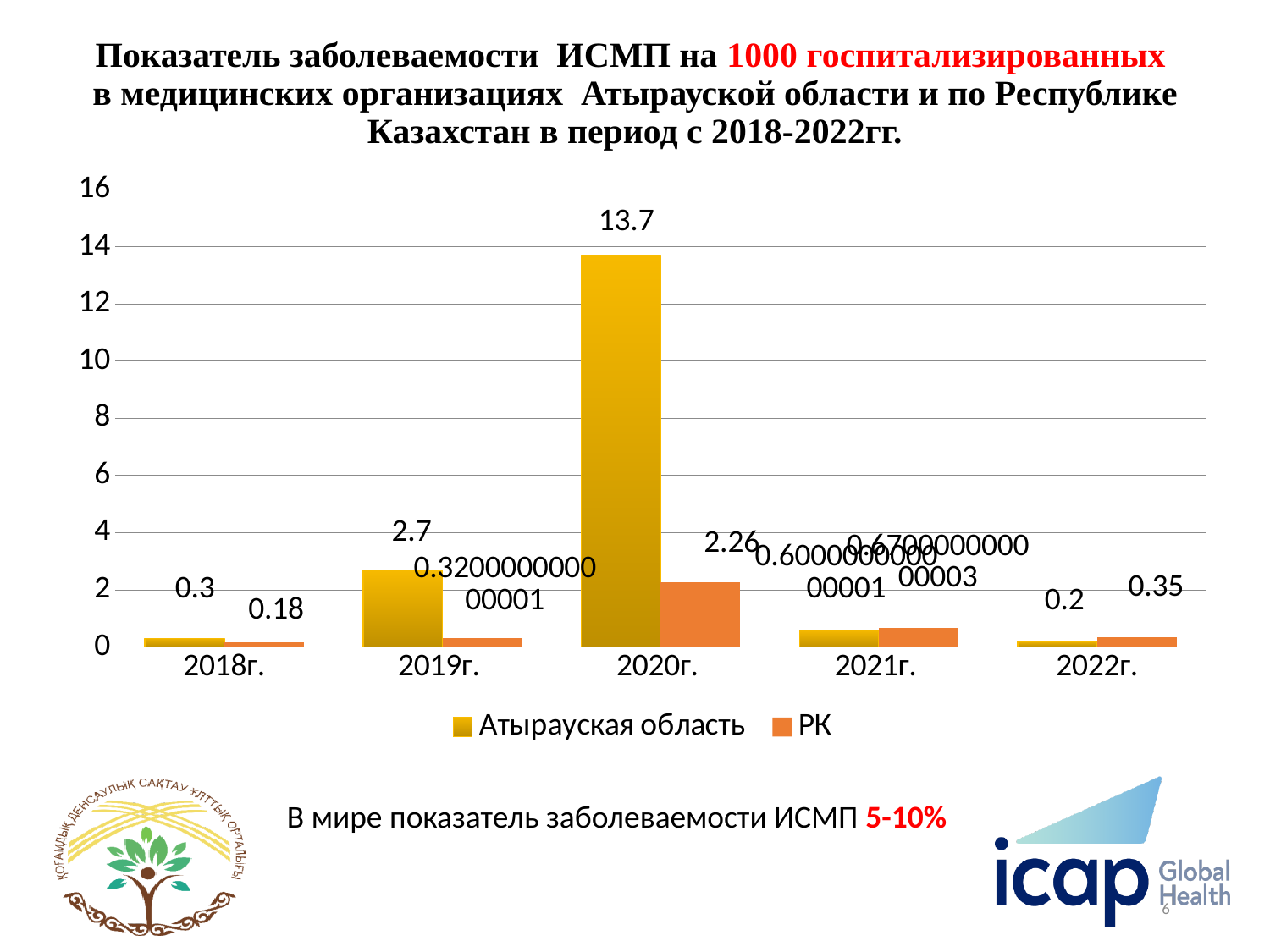
What is the value for РК in 2020г.? 2.26 How many years are shown on the x axis? 5 In 2022г., which series has the larger value, Атырауская область or РК? РК What kind of chart is shown on the slide? bar chart What is the difference between the Атырауская область and РК values in 2020г.? 11.44 What is the value for РК in 2022г.? 0.35 What is the difference between the Атырауская область and РК values in 2018г.? 0.12 What is the value for Атырауская область in 2019г.? 2.7 What is the value for Атырауская область in 2020г.? 13.7 How many series does the legend list? 2 In which year is the value for Атырауская область the highest? 2020г. What is the value for РК in 2018г.? 0.18